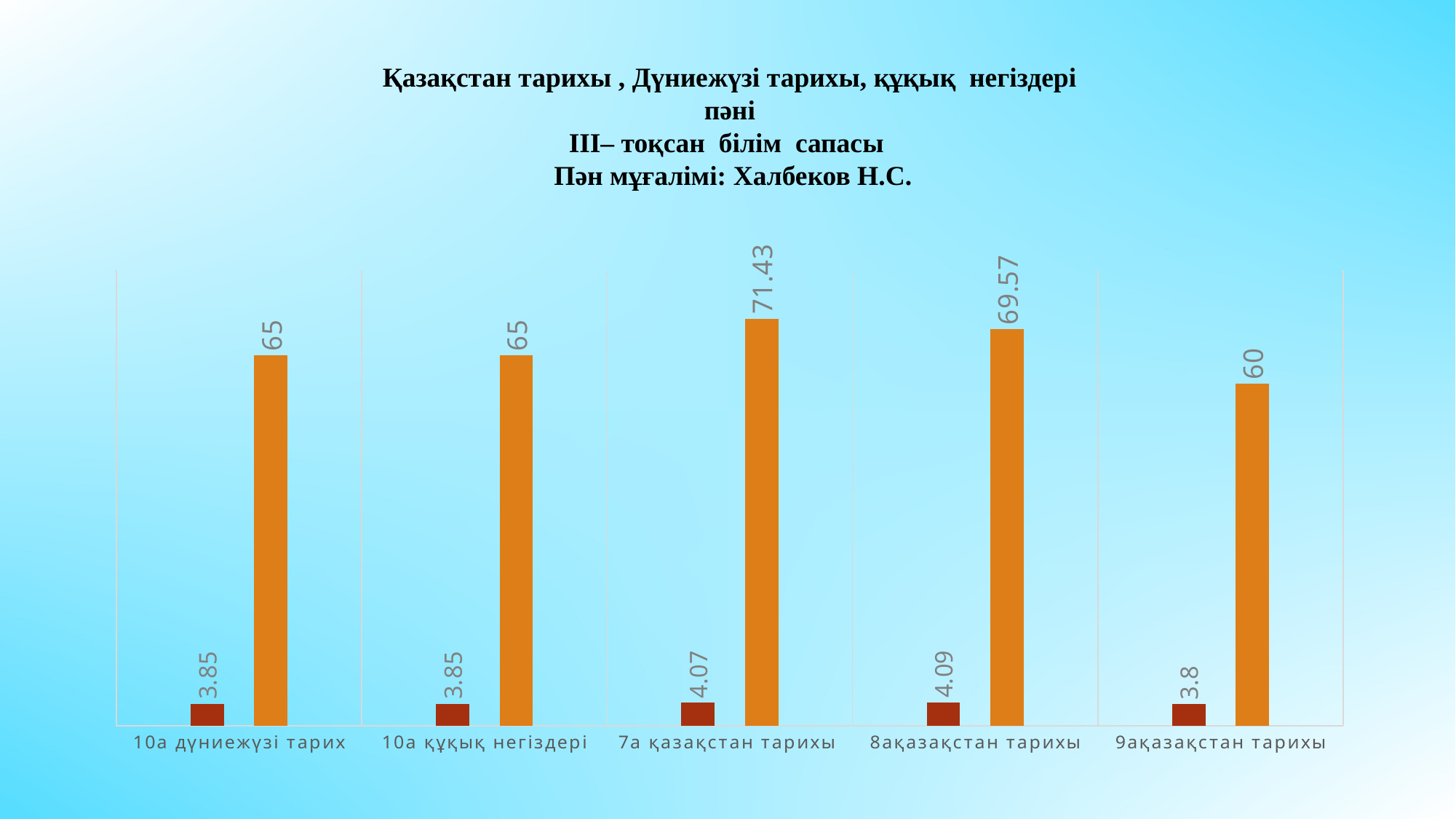
Which is larger: the orange bar for 8ақазақстан тарихы or the orange bar for 10а құқық негіздері? 8ақазақстан тарихы How many categories are shown on the x axis? 5 Which category has the lowest orange bar? 9ақазақстан тарихы What is the difference between the orange bar values for 7а қазақстан тарихы and 9ақазақстан тарихы? 11.43 What is the value of the dark red bar for 8ақазақстан тарихы? 4.09 Which category has the lowest dark red bar? 9ақазақстан тарихы What is the value of the dark red bar for 10а дүниежүзі тарих? 3.85 What is the difference between the dark red bar values for 8ақазақстан тарихы and 7а қазақстан тарихы? 0.02 What kind of chart is shown on the slide? Bar chart What is the value of the orange bar for 9ақазақстан тарихы? 60 What is the value of the orange bar for 7а қазақстан тарихы? 71.43 Which category has the highest orange bar? 7а қазақстан тарихы